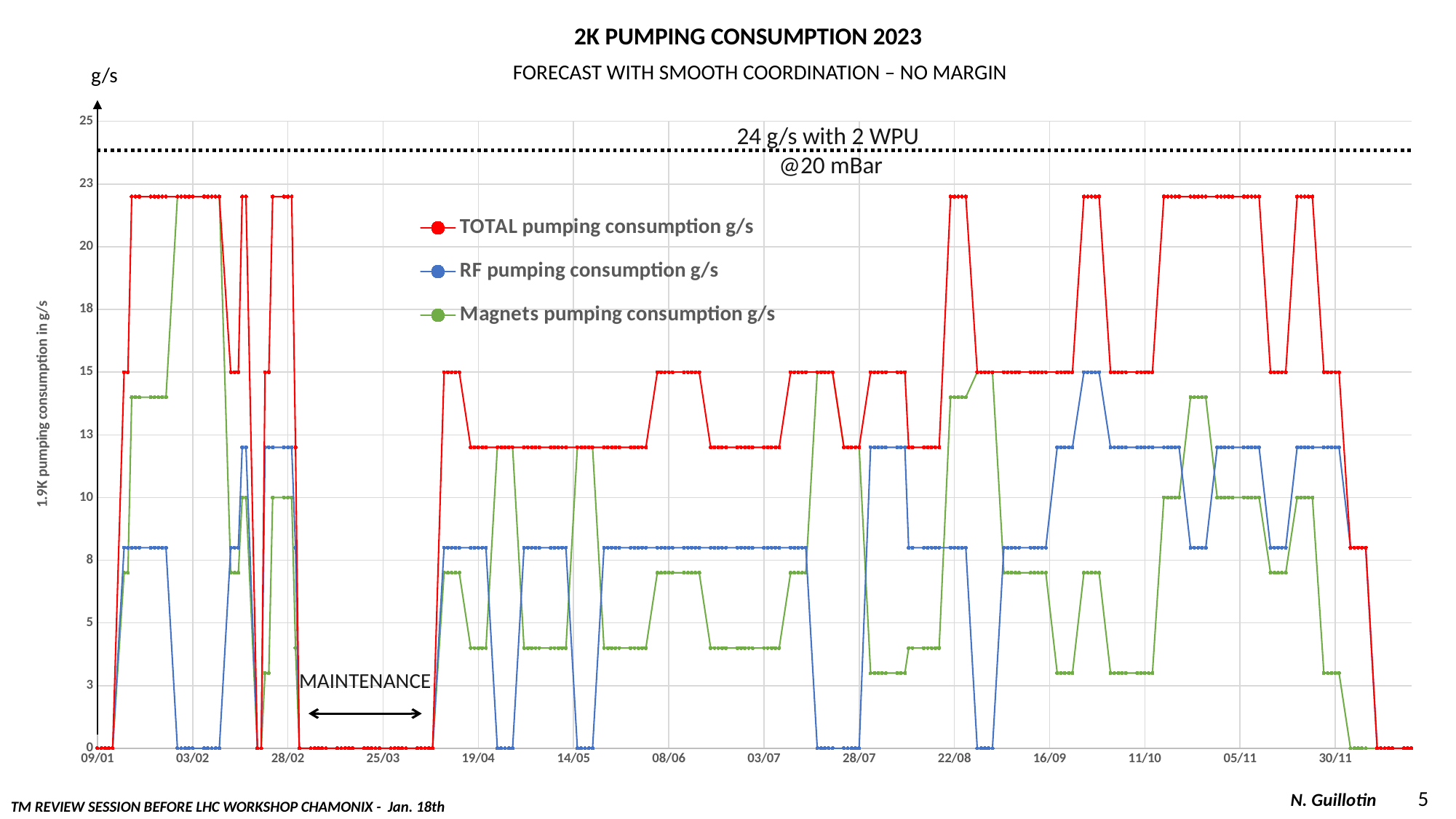
Does the TOTAL pumping consumption rise or fall from 30/11 to the end of the year? fall Around 03/07, which is higher: RF pumping consumption or Magnets pumping consumption? RF pumping consumption g/s Is the Magnets pumping consumption around 11/10 greater or less than 5? less Is the TOTAL pumping consumption around 22/08 greater or less than 20? greater Which series reaches the highest values on the chart? TOTAL pumping consumption g/s How many series does the legend list? 3 Is the RF pumping consumption around 03/07 greater or less than 10? less What limit does the dotted horizontal line near the top of the chart represent? 24 g/s with 2 WPU @20 mBar What is the TOTAL pumping consumption during the MAINTENANCE period around 25/03? 0 What kind of chart is shown on the slide? line chart What is the title of the chart? 2K PUMPING CONSUMPTION 2023